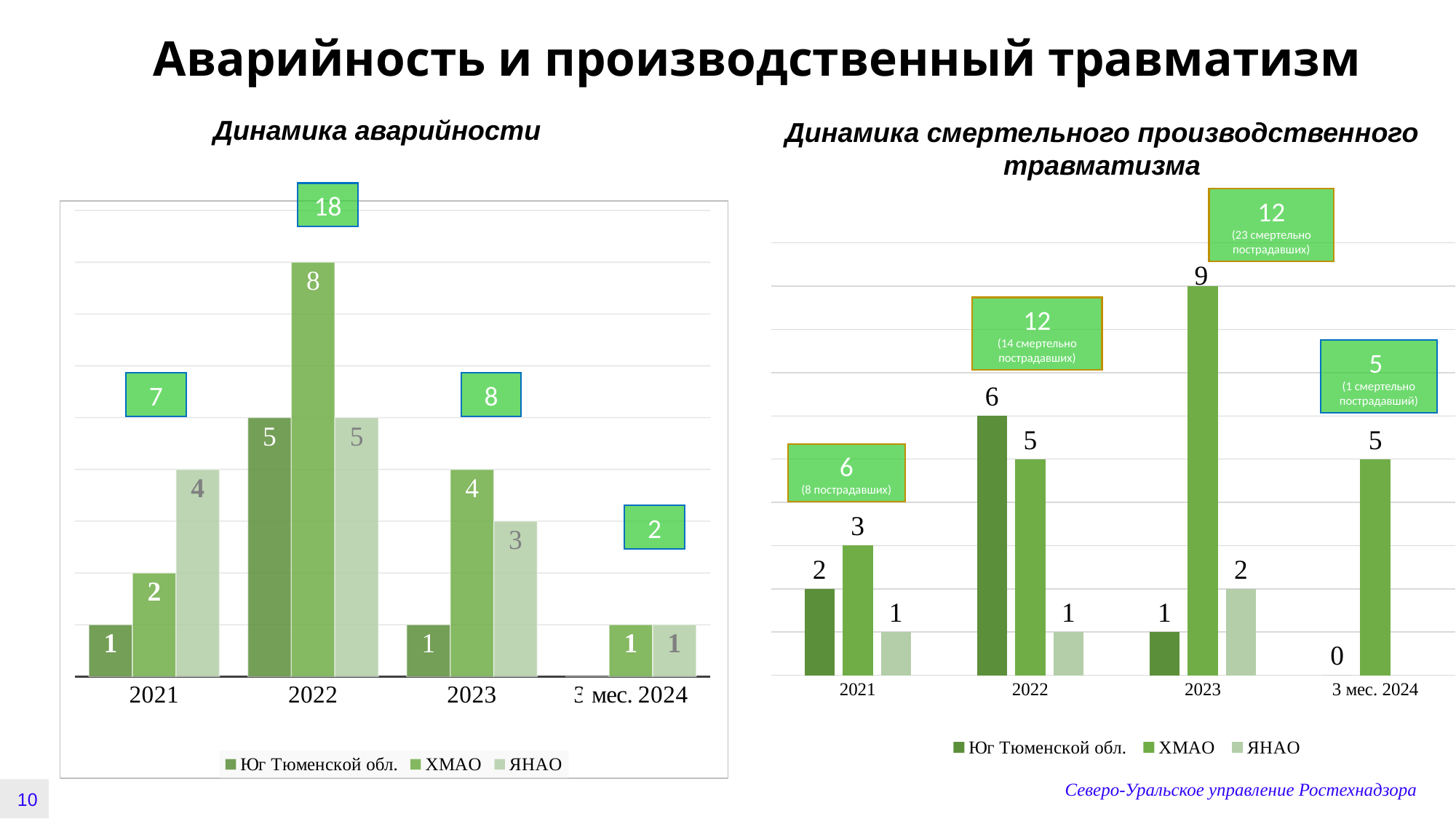
On the chart 'Динамика смертельного производственного травматизма', which is larger in 2021: Юг Тюменской обл. or ХМАО? ХМАО On the chart 'Динамика аварийности', what is the value for ЯНАО in 2021? 4 On the chart 'Динамика смертельного производственного травматизма', what is the difference between the ХМАО values for 2023 and 2022? 4 What type of chart is 'Динамика смертельного производственного травматизма'? Bar chart On the chart 'Динамика смертельного производственного травматизма', what is the value for Юг Тюменской обл. in 2022? 6 On the chart 'Динамика аварийности', what is the value for ХМАО in 2022? 8 On the chart 'Динамика аварийности', what is the total shown in the box above the 2022 group? 18 On the chart 'Динамика смертельного производственного травматизма', how many categories are shown on the x axis? 4 On the chart 'Динамика аварийности', which year has the highest value for ХМАО? 2022 On the chart 'Динамика аварийности', how many series does the legend list? 3 On the chart 'Динамика аварийности', what is the difference between the ХМАО values for 2022 and 2023? 4 On the chart 'Динамика смертельного производственного травматизма', what is the value for ХМАО in 2023? 9